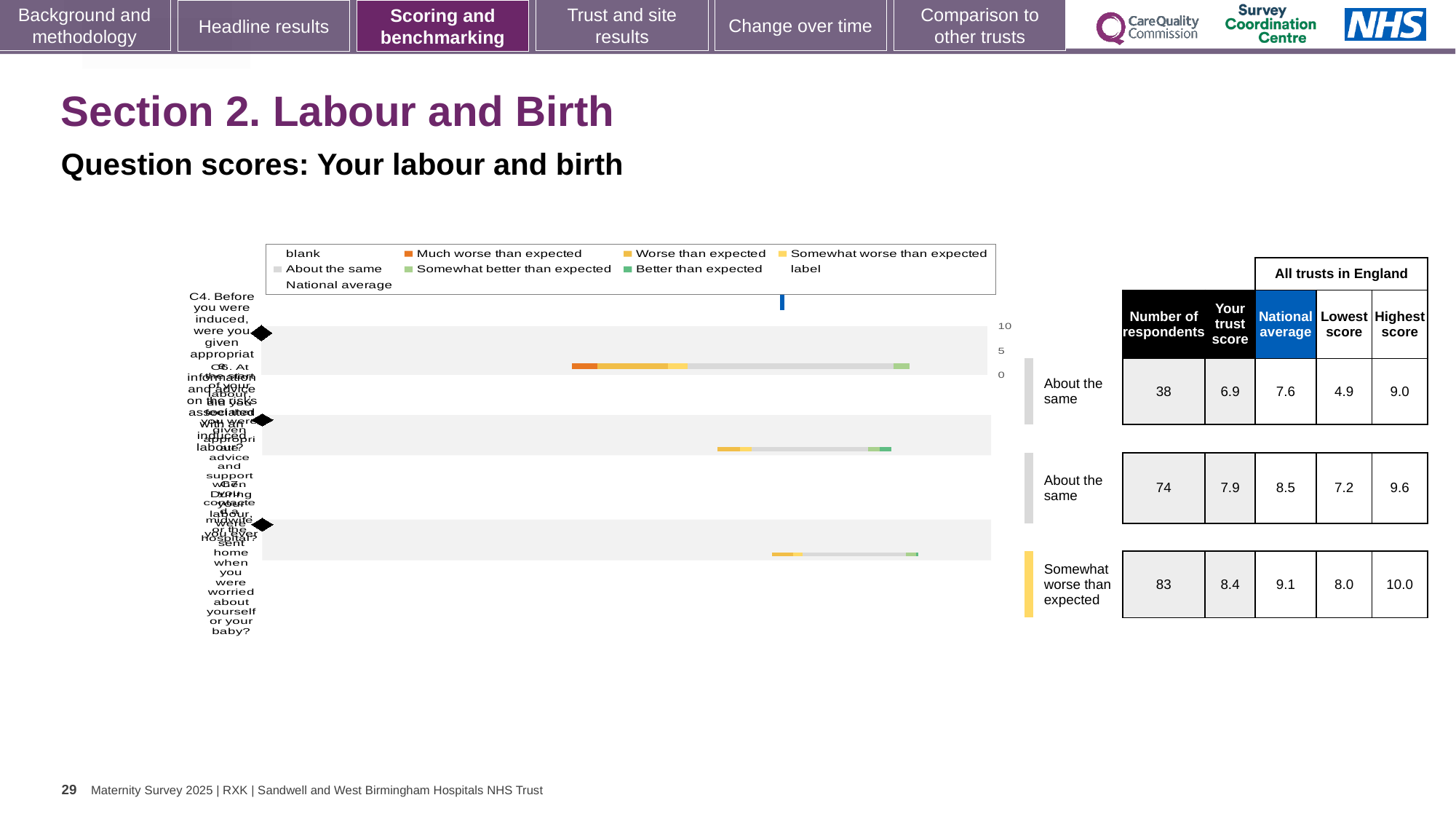
In the table, what is the difference between the national average and the trust score in the row rated 'Somewhat worse than expected'? 0.7 In the first row of the table, which is larger: the trust score or the national average? the national average In the table, which row has the highest number of respondents? the third row (Somewhat worse than expected), 83 Which legend entry is shown with an orange colour? Much worse than expected What kind of chart is shown on the slide? bar chart In the table, what is the highest score for the row rated 'Somewhat worse than expected'? 10.0 In the table, what is the national average for the row rated 'Somewhat worse than expected'? 9.1 In the table, what is the number of respondents for the row rated 'Somewhat worse than expected'? 83 How many horizontal bars are plotted in the chart? 3 In the table, what is the trust score for the row rated 'Somewhat worse than expected'? 8.4 In the table, what is the lowest score in the second row? 7.2 In the table, what is the number of respondents in the first row? 38